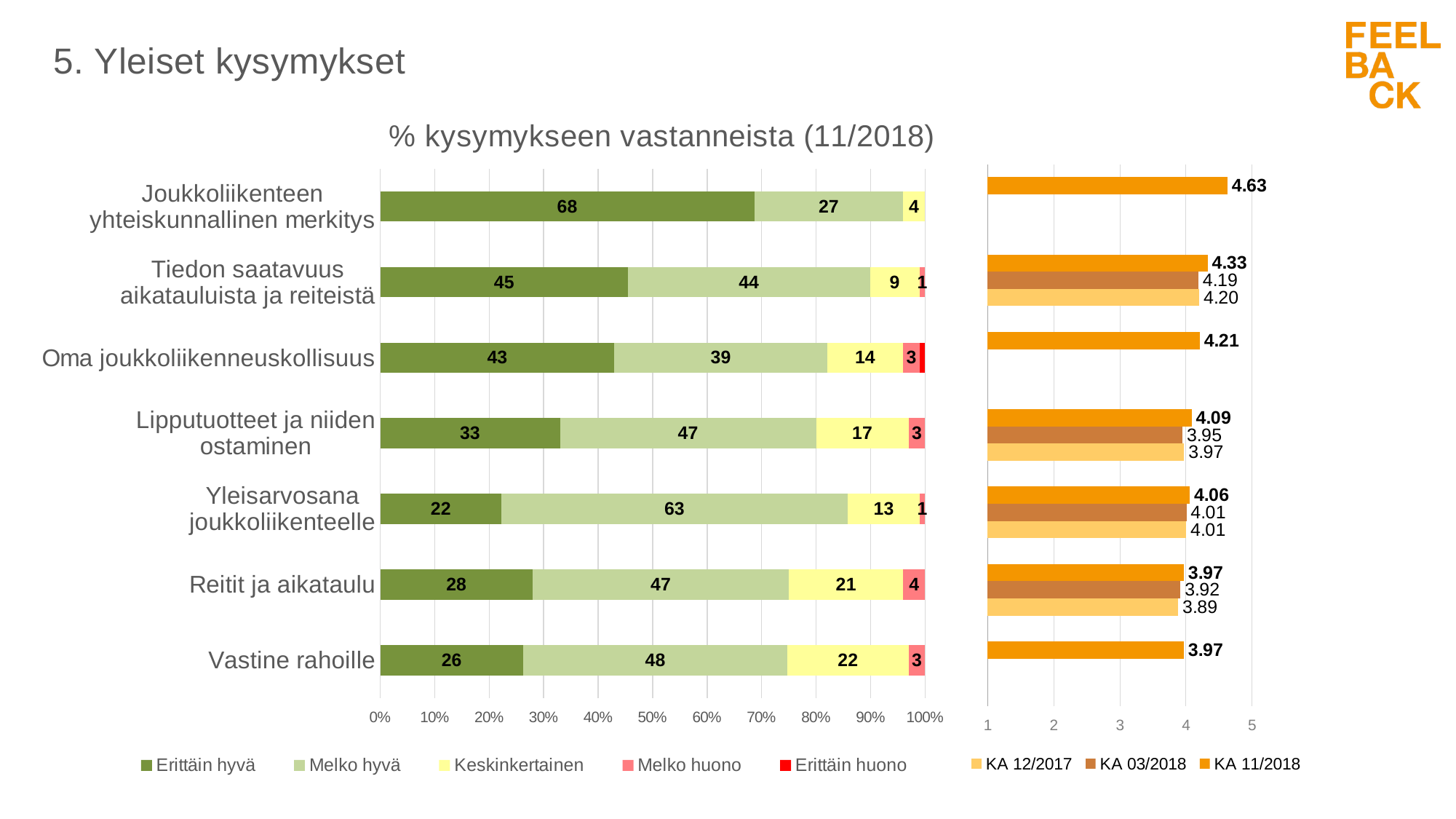
In the right chart of averages, what is the KA 11/2018 value for 'Joukkoliikenteen yhteiskunnallinen merkitys'? 4.63 What kind of chart is the left chart '% kysymykseen vastanneista (11/2018)'? Stacked bar chart How many categories are shown in the left chart '% kysymykseen vastanneista (11/2018)'? 7 In the right chart of averages, which is larger for 'Lipputuotteet ja niiden ostaminen': KA 12/2017 or KA 03/2018? KA 12/2017 In the left chart '% kysymykseen vastanneista (11/2018)', how much larger is the 'Erittäin hyvä' value for 'Tiedon saatavuus aikatauluista ja reiteistä' than for 'Oma joukkoliikenneuskollisuus'? 2 How many series does the legend of the right chart of averages list? 3 In the left chart '% kysymykseen vastanneista (11/2018)', what percentage of respondents rated 'Joukkoliikenteen yhteiskunnallinen merkitys' as 'Erittäin hyvä'? 68 In the left chart '% kysymykseen vastanneista (11/2018)', what is the 'Melko hyvä' value for 'Yleisarvosana joukkoliikenteelle'? 63 In the left chart '% kysymykseen vastanneista (11/2018)', which category has the highest 'Erittäin hyvä' share? Joukkoliikenteen yhteiskunnallinen merkitys In the right chart of averages, what is the KA 03/2018 value for 'Reitit ja aikataulu'? 3.92 How many series does the legend of the left chart '% kysymykseen vastanneista (11/2018)' list? 5 In the left chart '% kysymykseen vastanneista (11/2018)', which category has the lowest 'Erittäin hyvä' share? Yleisarvosana joukkoliikenteelle